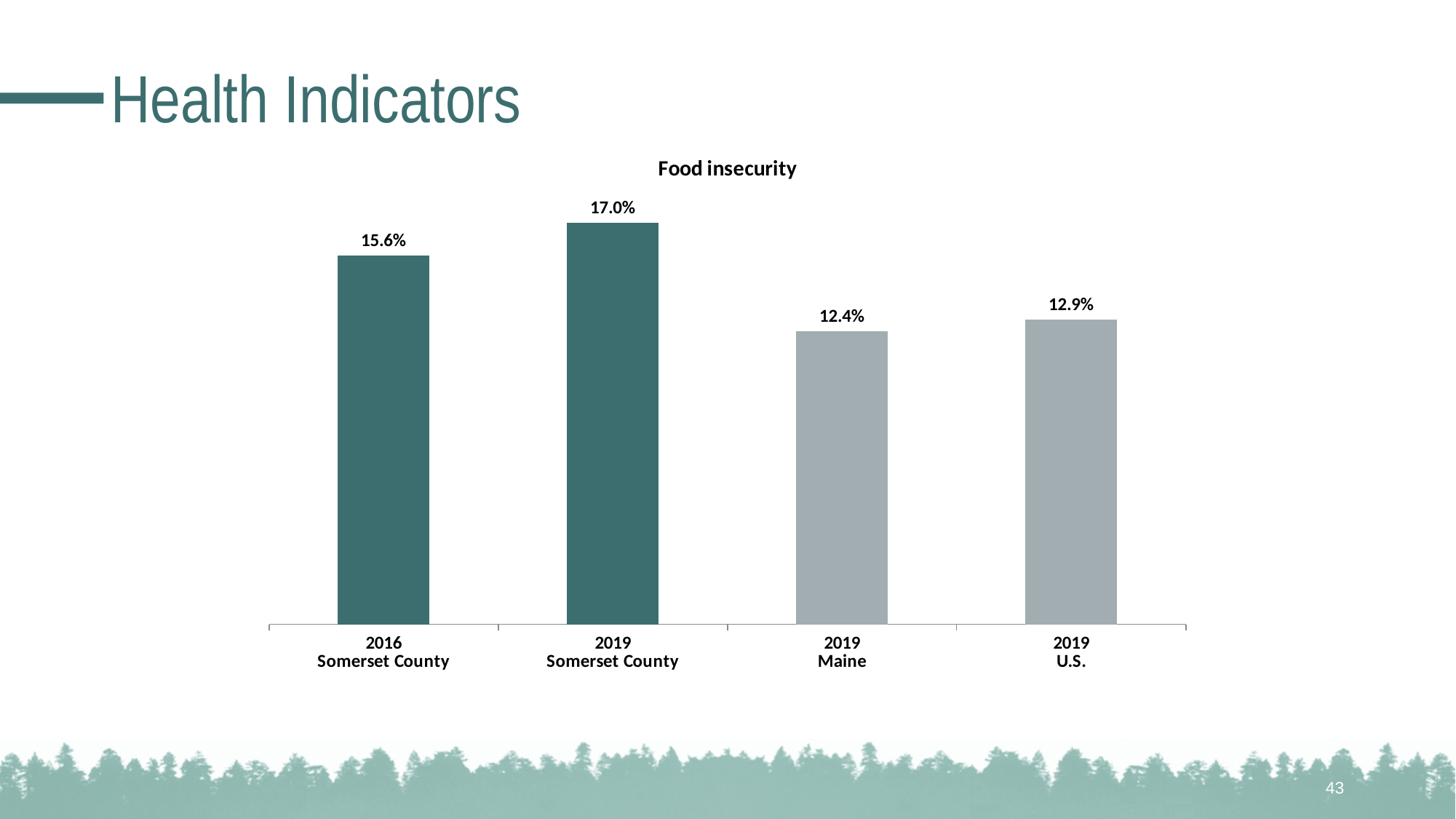
What is the difference between the 2019 Somerset County and 2016 Somerset County food insecurity values? 1.4% Which is larger, the food insecurity value for 2019 Somerset County or for 2019 U.S.? 2019 Somerset County How many categories are shown in the Food insecurity chart? 4 What is the difference between the 2019 U.S. and 2019 Maine food insecurity values? 0.5% What is the food insecurity value for 2019 Somerset County? 17.0% What is the food insecurity value for 2019 U.S.? 12.9% What is the food insecurity value for 2016 Somerset County? 15.6% Which category has the highest food insecurity value? 2019 Somerset County What kind of chart is shown on the slide? Bar chart What is the food insecurity value for 2019 Maine? 12.4% Which category has the lowest food insecurity value? 2019 Maine What is the title of the chart? Food insecurity